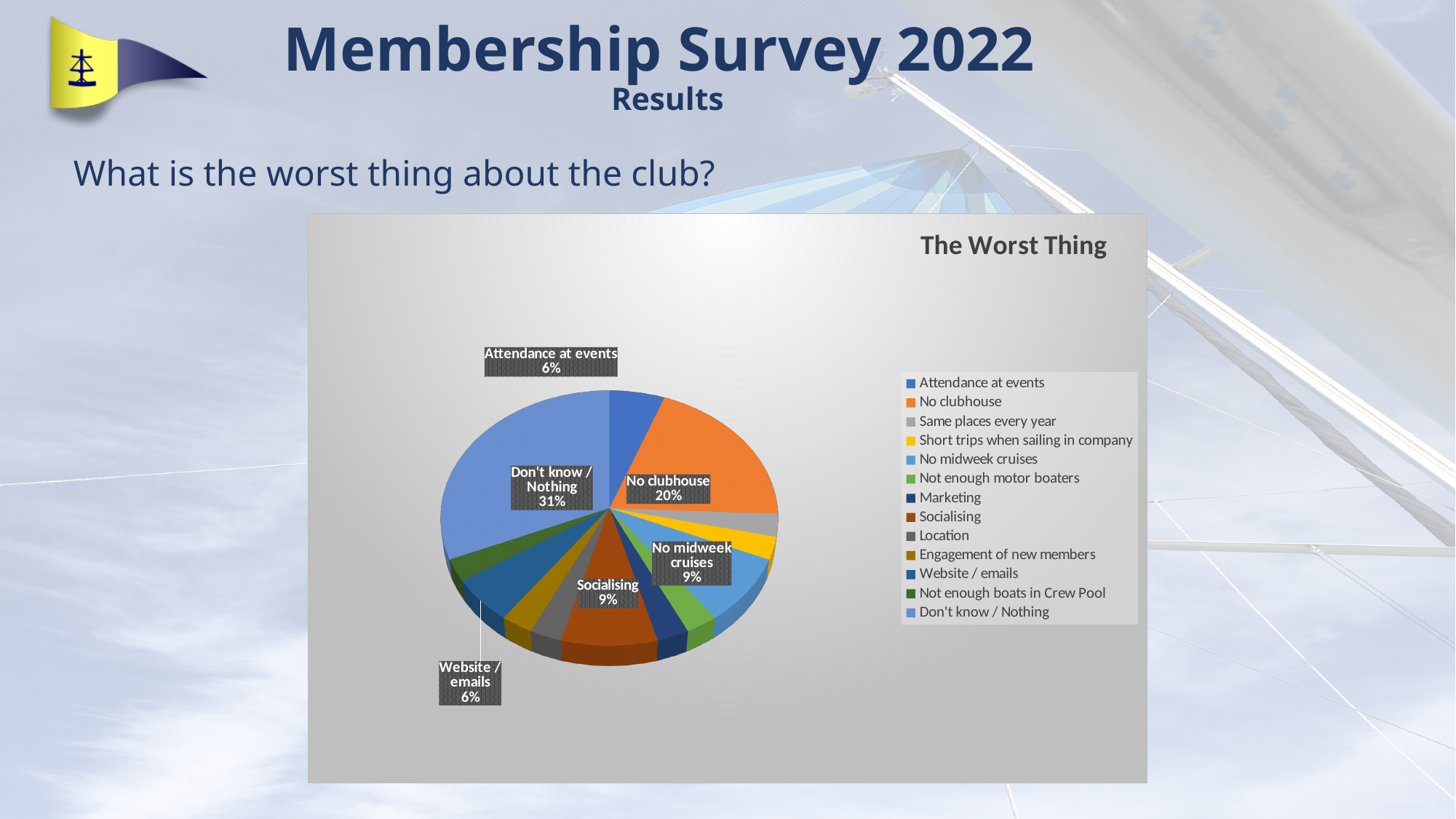
What is the difference in percentage points between 'Don't know / Nothing' and 'No clubhouse'? 11 What is the title of the chart? The Worst Thing Which category has the largest slice of the pie? Don't know / Nothing What percentage is shown for 'Socialising'? 9% What percentage is shown for 'No clubhouse'? 20% What percentage is shown for 'Attendance at events'? 6% Which is larger, the slice for 'No clubhouse' or the slice for 'No midweek cruises'? No clubhouse What kind of chart is shown on the slide? pie chart What percentage is shown for 'Website / emails'? 6% What percentage is shown for 'No midweek cruises'? 9% What percentage of the pie is labelled for 'Don't know / Nothing'? 31% How many categories does the legend list? 13